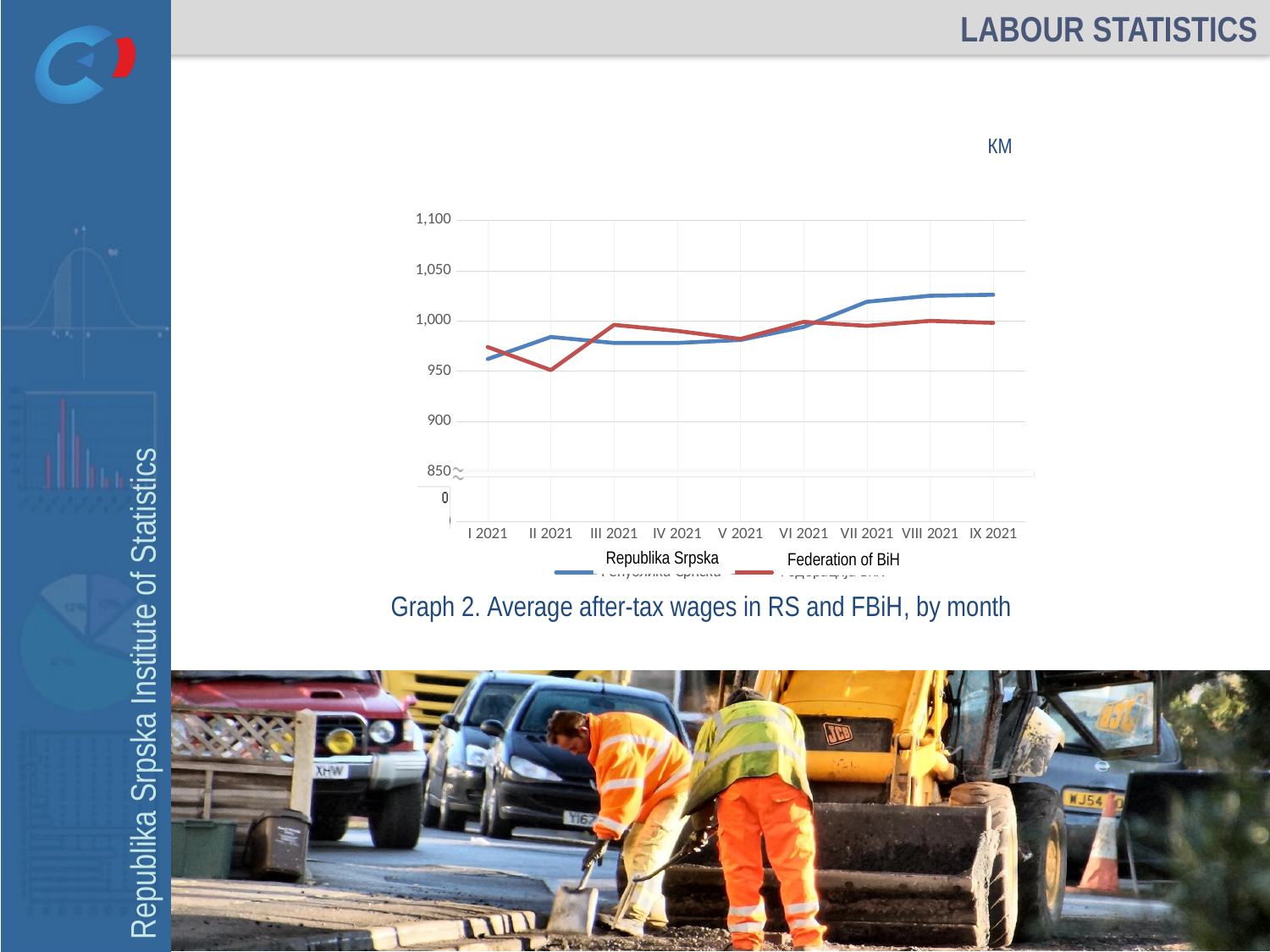
In II 2021, which series has the higher value, Republika Srpska or Federation of BiH? Republika Srpska What kind of chart is shown on the slide? line chart In which month does the Republika Srpska series have its lowest value? I 2021 How many series does the legend list? 2 In which month does the Federation of BiH series reach its lowest value? II 2021 Is the value for Federation of BiH in II 2021 greater or less than 1,000? less Is the value for Republika Srpska in I 2021 greater or less than 1,000? less Does the Republika Srpska series generally rise or fall from I 2021 to IX 2021? rise Is the value for Republika Srpska in IX 2021 greater or less than 1,000? greater In IX 2021, which series has the higher value, Republika Srpska or Federation of BiH? Republika Srpska How many months are plotted along the x axis? 9 What is the title of the graph? Graph 2. Average after-tax wages in RS and FBiH, by month